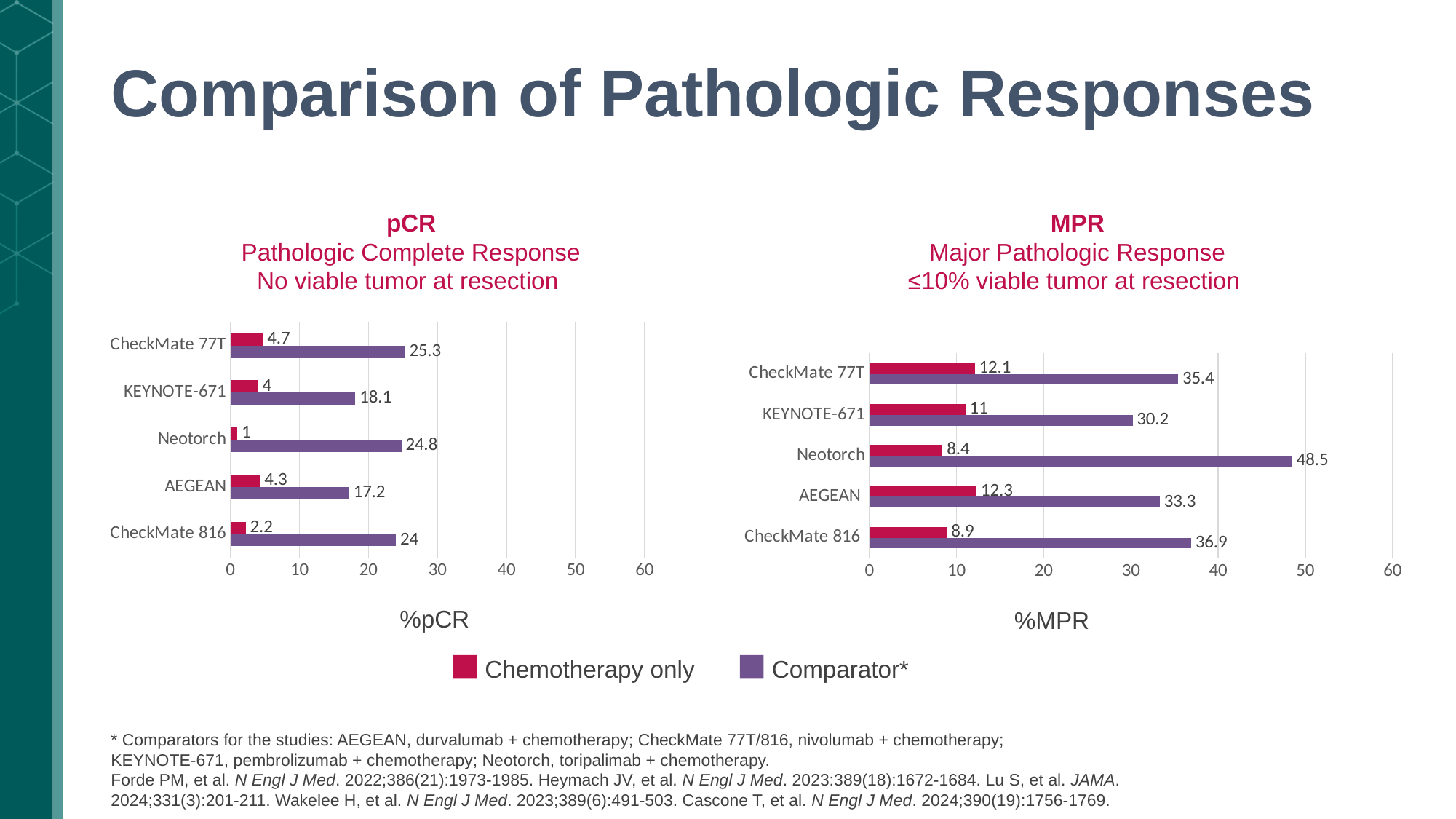
What is the x-axis label of the MPR chart? %MPR What kind of chart is the MPR chart? bar chart In the MPR chart, which is larger: the Comparator* value for CheckMate 816 or for AEGEAN? CheckMate 816 In the MPR chart, is the Comparator* value for Neotorch greater or less than 40? greater In the pCR chart, what is the Chemotherapy only value for CheckMate 816? 2.2 In the MPR chart, what is the Chemotherapy only value for AEGEAN? 12.3 In the pCR chart, what is the difference between the Comparator* and Chemotherapy only values for KEYNOTE-671? 14.1 In the MPR chart, which study has the highest Comparator* value? Neotorch In the pCR chart, what is the Comparator* value for CheckMate 77T? 25.3 How many studies are shown in the pCR chart? 5 In the pCR chart, which study has the lowest Chemotherapy only value? Neotorch How many series does the legend list? 2